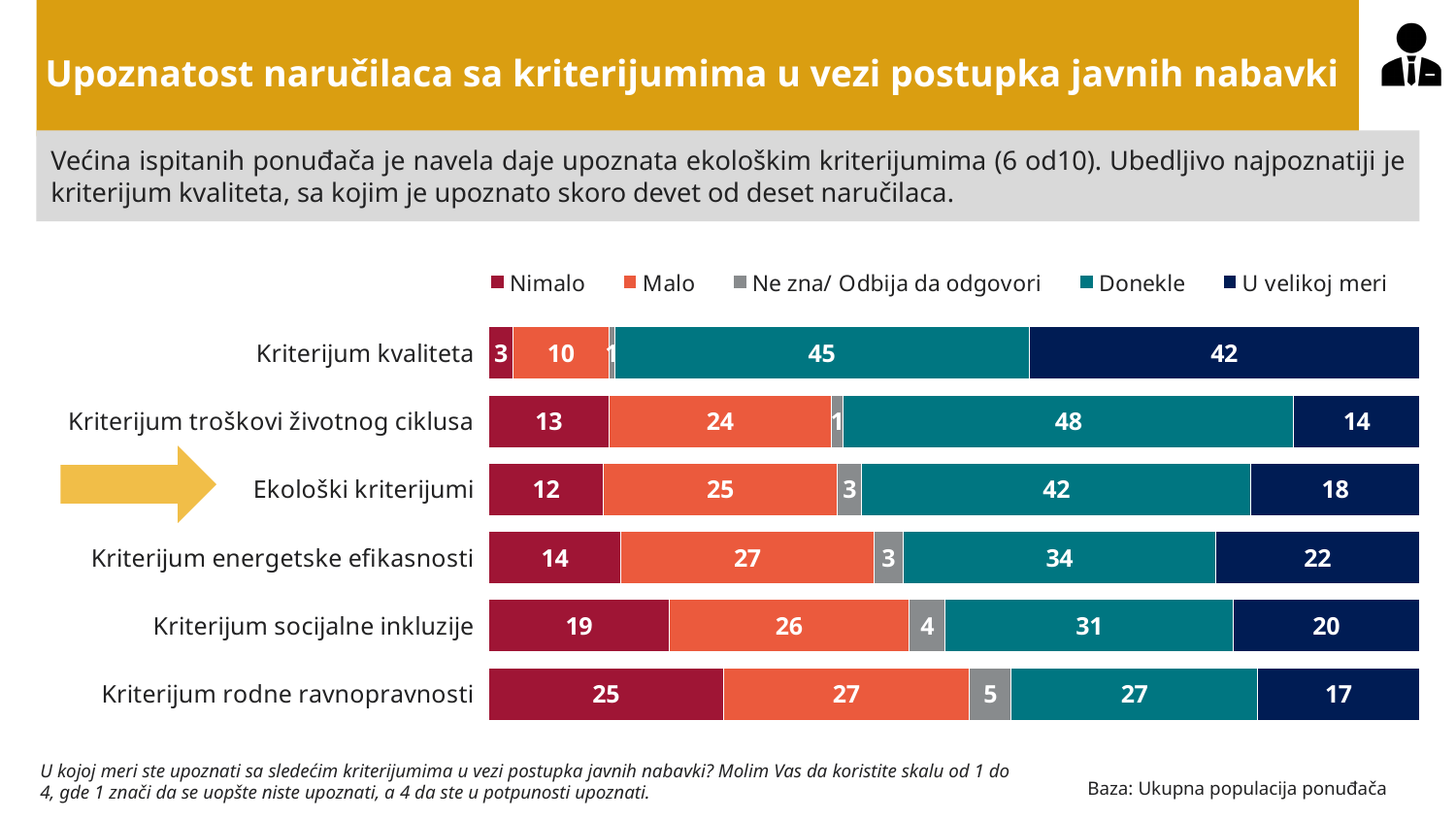
What is the difference between the "Malo" value for Kriterijum energetske efikasnosti and the "Malo" value for Kriterijum kvaliteta? 17 Which category has the lowest "U velikoj meri" value? Kriterijum troškovi životnog ciklusa Which has a larger "Donekle" value: Ekološki kriterijumi or Kriterijum socijalne inkluzije? Ekološki kriterijumi How many series does the legend list? 5 How many categories (criteria) are shown in the chart? 6 What is the value of "Donekle" for Kriterijum troškovi životnog ciklusa? 48 What kind of chart is shown on the slide? Stacked bar chart Which category has the highest "Nimalo" value? Kriterijum rodne ravnopravnosti What is the total of the stacked bar for Ekološki kriterijumi? 100 Which legend entry is shown in orange? Malo What is the value of "U velikoj meri" for Kriterijum kvaliteta? 42 What is the value of "Nimalo" for Kriterijum rodne ravnopravnosti? 25